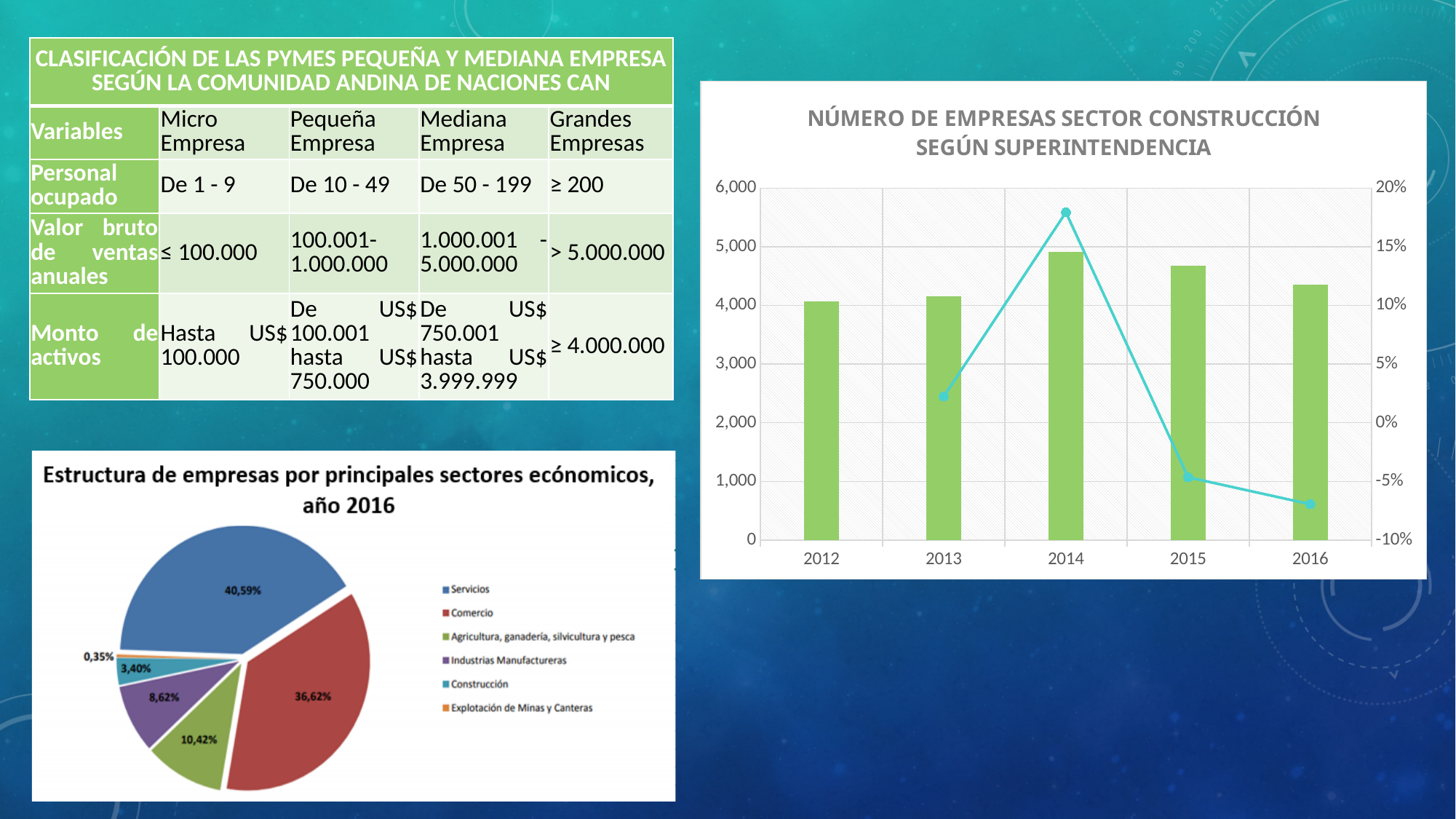
In the pie chart 'Estructura de empresas por principales sectores económicos, año 2016', what share does Industrias Manufactureras have? 8,62% In the pie chart 'Estructura de empresas por principales sectores económicos, año 2016', what is the difference between the shares of Servicios and Comercio? 3,97% In the pie chart 'Estructura de empresas por principales sectores económicos, año 2016', what share does Servicios have? 40,59% In the pie chart 'Estructura de empresas por principales sectores económicos, año 2016', how many sectors are shown? 6 In the chart 'Número de empresas sector construcción según Superintendencia', is the bar for 2012 greater or less than 5,000? less In the pie chart 'Estructura de empresas por principales sectores económicos, año 2016', which is larger: Agricultura, ganadería, silvicultura y pesca or Construcción? Agricultura, ganadería, silvicultura y pesca In the pie chart 'Estructura de empresas por principales sectores económicos, año 2016', what share does Comercio have? 36,62% In the chart 'Número de empresas sector construcción según Superintendencia', is the line value for 2014 greater or less than 15%? greater In the pie chart 'Estructura de empresas por principales sectores económicos, año 2016', which sector has the smallest share? Explotación de Minas y Canteras In the chart 'Número de empresas sector construcción según Superintendencia', which year has the tallest bar? 2014 In the pie chart 'Estructura de empresas por principales sectores económicos, año 2016', which sector has the largest share? Servicios In the chart 'Número de empresas sector construcción según Superintendencia', how many years are shown on the x axis? 5